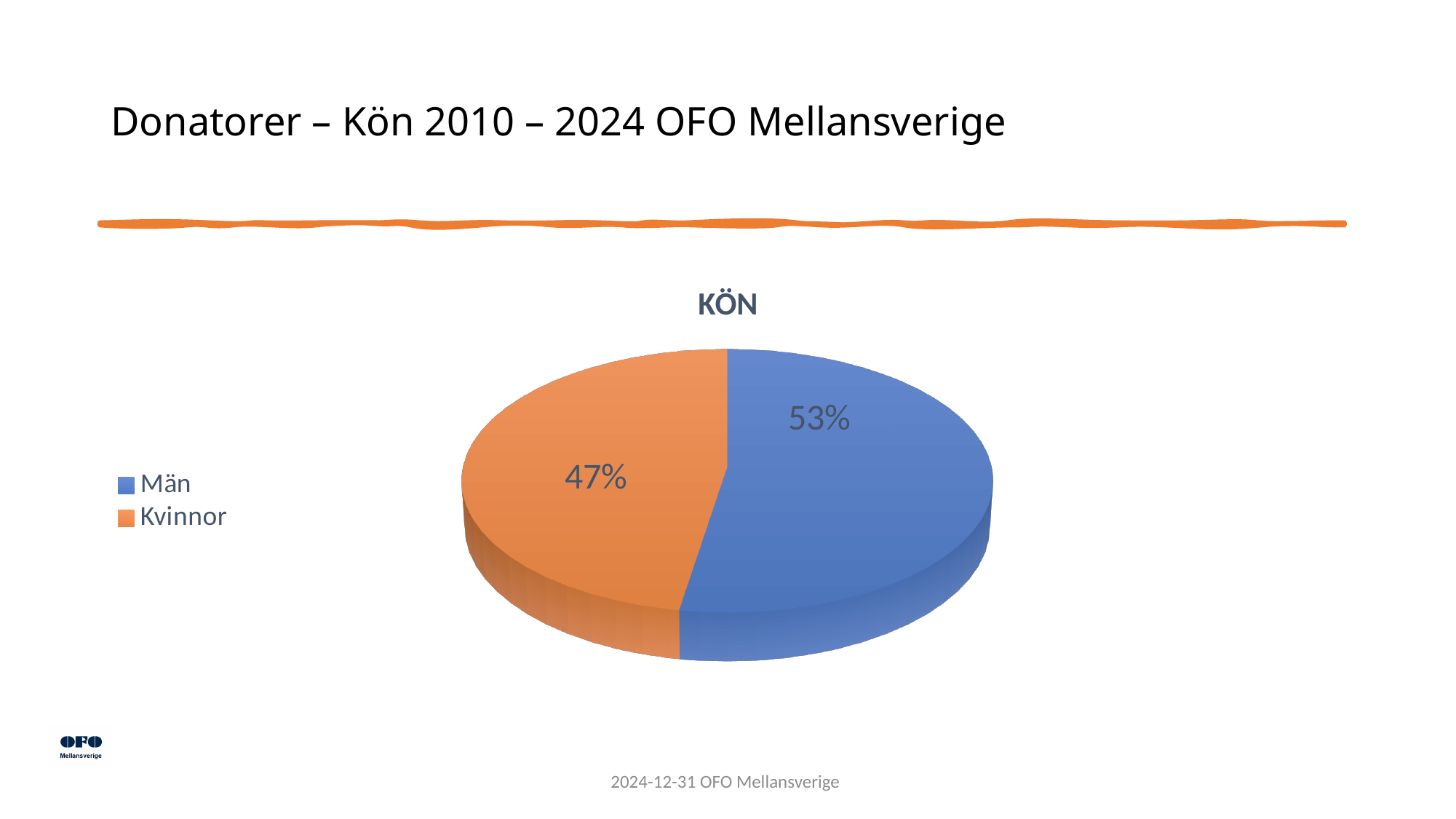
What is the title of the chart? KÖN What kind of chart is shown on the slide? pie chart What is the difference in percentage points between the Män and Kvinnor slices? 6 Which slice is larger, Män or Kvinnor? Män Is the share for Män greater or less than 50%? greater What colour is the Kvinnor slice? orange How many slices does the pie chart have? 2 Which category has the largest slice of the pie? Män What share of the pie does Män represent? 53% Which category has the smallest slice of the pie? Kvinnor What share of the pie does Kvinnor represent? 47%